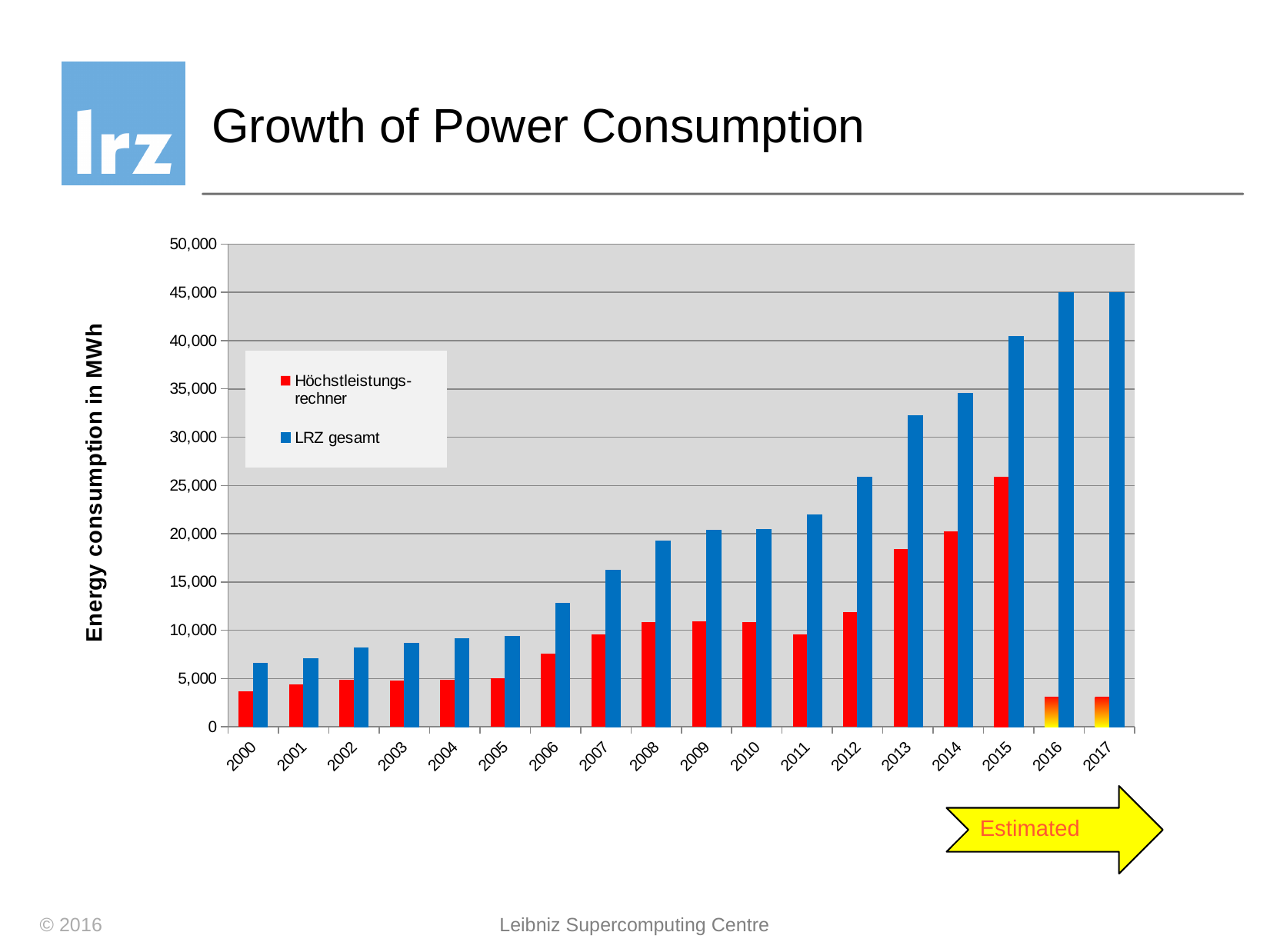
How many series does the legend list? 2 What kind of chart is shown on the slide? bar chart What is the value of LRZ gesamt for 2016? 45,000 In which year is the LRZ gesamt value lowest? 2000 Is the LRZ gesamt value for 2006 greater or less than 10,000? greater Does the LRZ gesamt series generally rise or fall from 2000 to 2017? rise How many years are shown on the x axis? 18 Which is larger, the Höchstleistungsrechner value for 2011 or for 2012? 2012 In which year is the Höchstleistungsrechner value highest? 2015 Is the Höchstleistungsrechner value for 2013 greater or less than 15,000? greater What is the label of the y axis? Energy consumption in MWh